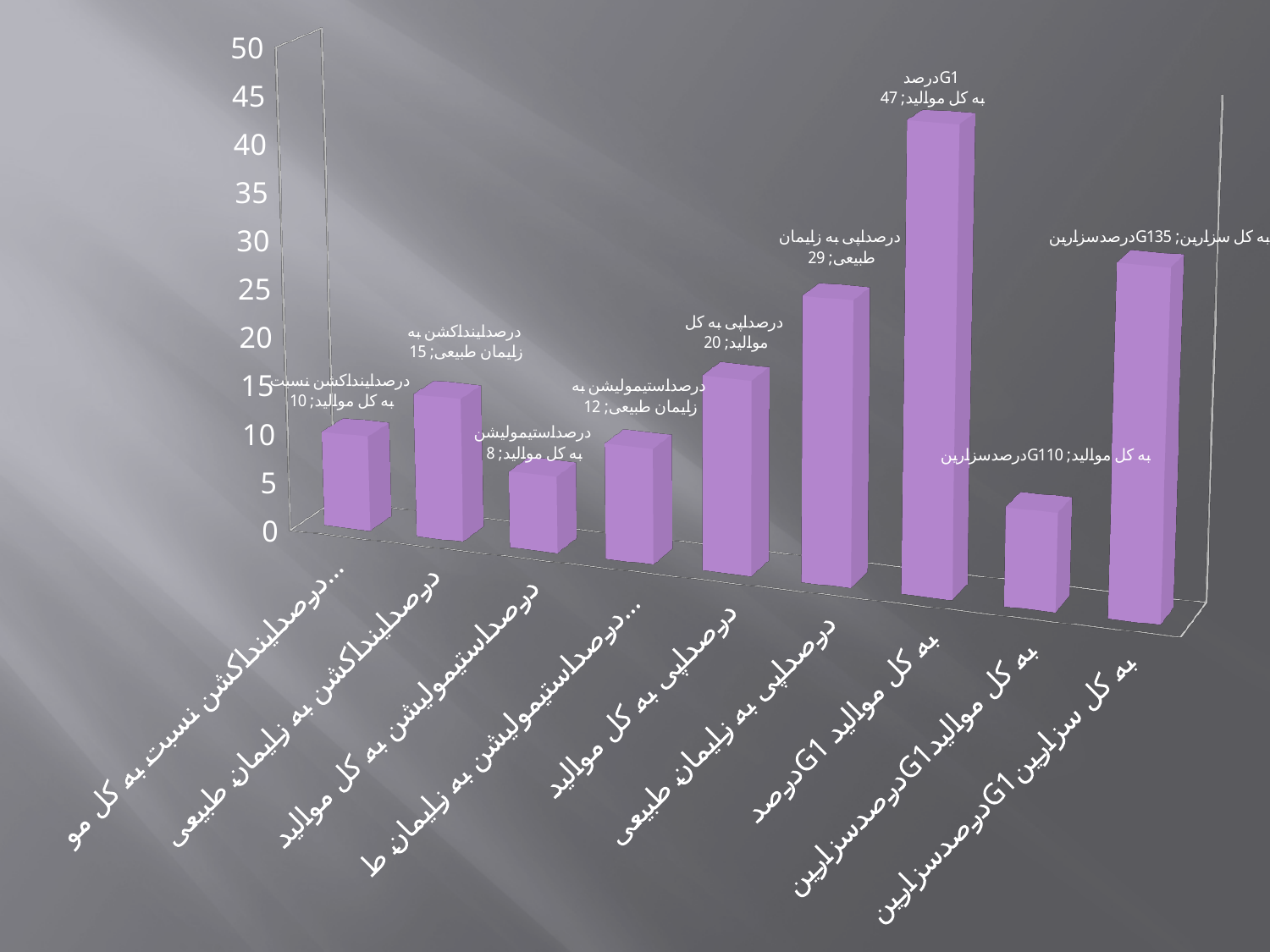
What is the value for "درصدسزارین G1 به کل سزارین"? 35 What is the value for "درصداستیمولیشن به کل موالید"? 8 Which category has the highest value? درصد G1 به کل موالید What is the value for "درصد G1 به کل موالید"? 47 What is the difference between the values for "درصدلپی به زایمان طبیعی" and "درصدلپی به کل موالید"? 9 What is the difference between the values for "درصد G1 به کل موالید" and "درصدسزارین G1 به کل سزارین"? 12 What is the value for "درصدلپی به زایمان طبیعی"? 29 Which is larger: the value for "درصدلیندلاکشن به زایمان طبیعی" or the value for "درصداستیمولیشن به زایمان طبیعی"? درصدلیندلاکشن به زایمان طبیعی How many bars (categories) does the chart show? 9 What kind of chart is shown on the slide? bar chart Which category has the lowest value? درصداستیمولیشن به کل موالید What is the maximum value shown on the vertical axis? 50